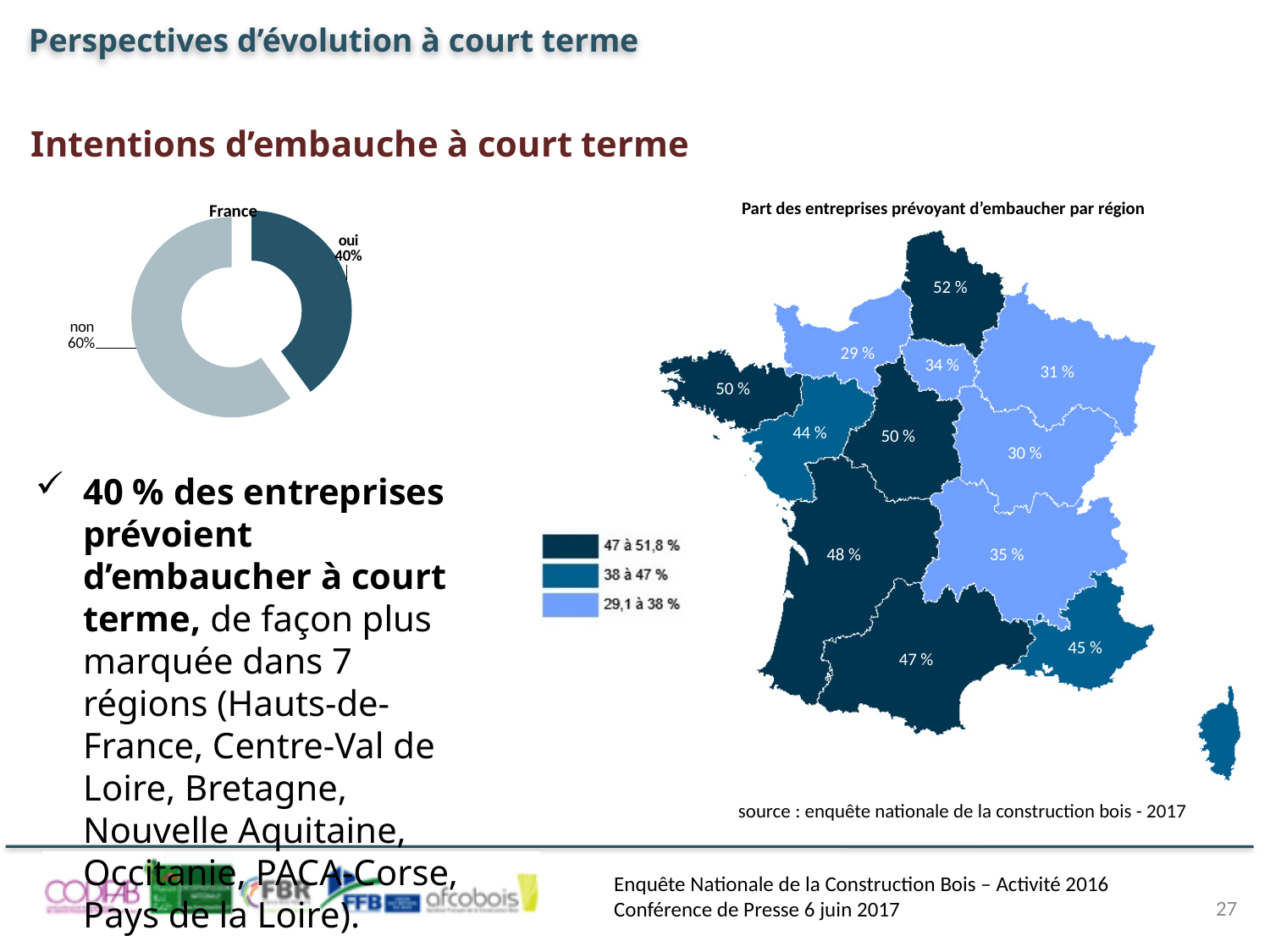
In the donut chart titled "France", what is the value for "oui"? 40% On the map titled "Part des entreprises prévoyant d'embaucher par région", what is the lowest regional value shown? 29 % What is the title of the chart on the left of the slide? France In the donut chart titled "France", which category has the smallest share? oui In the donut chart titled "France", what is the difference in percentage points between "non" and "oui"? 20 percentage points On the map titled "Part des entreprises prévoyant d'embaucher par région", what is the highest regional value shown? 52 % In the donut chart titled "France", which category has the largest share? non In the donut chart titled "France", which slice is larger, "oui" or "non"? non In the donut chart titled "France", what is the value for "non"? 60% What kind of chart is the chart titled "France" on the left of the slide? Donut (pie) chart How many categories does the donut chart titled "France" show? 2 How many value ranges does the legend of the map "Part des entreprises prévoyant d'embaucher par région" list? 3